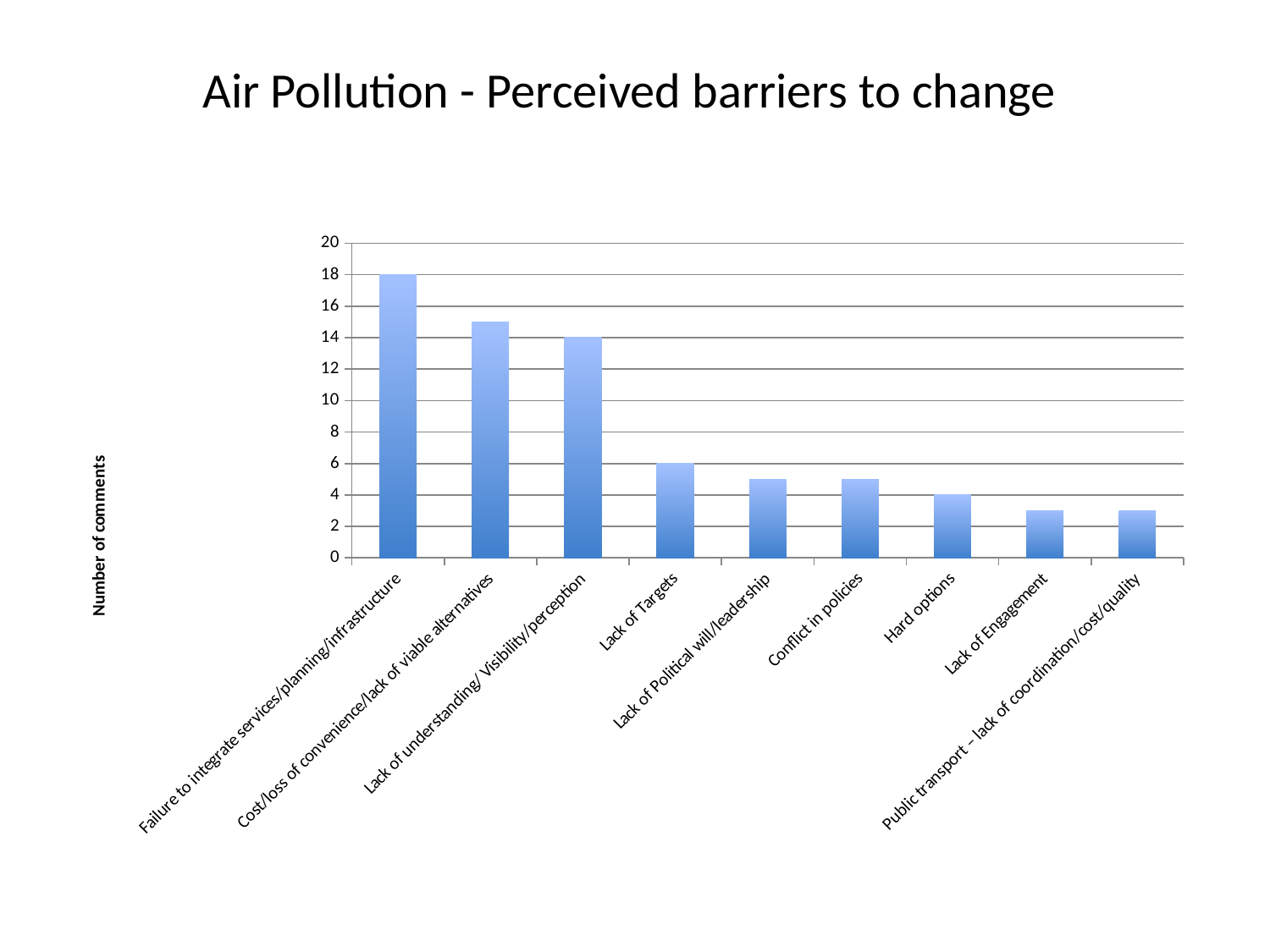
What kind of chart is shown on the slide? Bar chart Is the value for 'Lack of Engagement' greater or less than 4? less What is the label on the vertical axis? Number of comments How many categories (bars) are shown in the chart? 9 What is the difference in number of comments between 'Failure to integrate services/planning/infrastructure' and 'Lack of understanding/ Visibility/perception'? 4 Which category has the highest number of comments? Failure to integrate services/planning/infrastructure What is the number of comments for 'Failure to integrate services/planning/infrastructure'? 18 What is the number of comments for 'Lack of Targets'? 6 Is the value for 'Cost/loss of convenience/lack of viable alternatives' greater or less than 10? greater What is the title of the chart? Air Pollution - Perceived barriers to change What is the number of comments for 'Lack of understanding/ Visibility/perception'? 14 What is the number of comments for 'Hard options'? 4